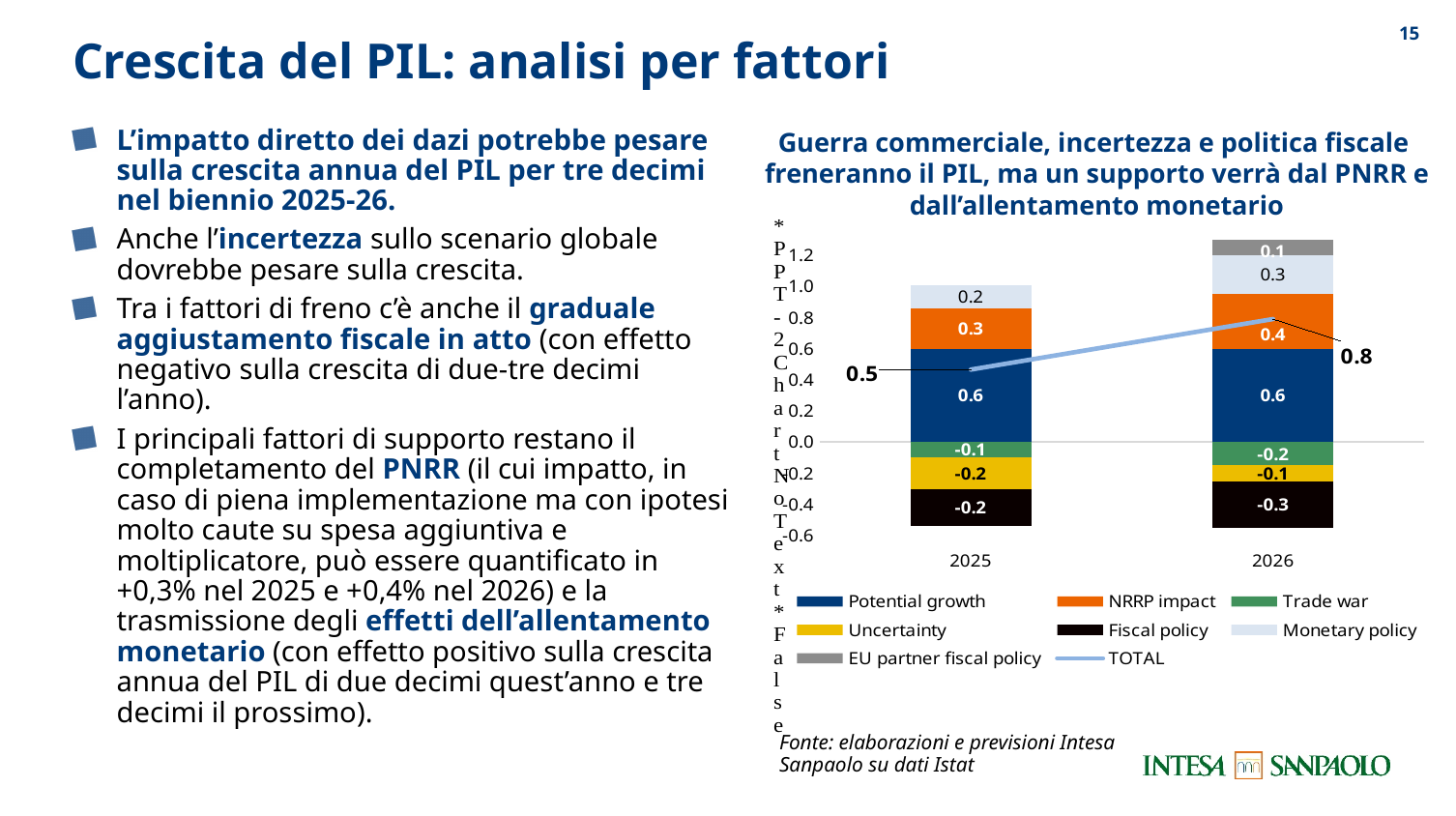
Does the TOTAL line rise or fall from 2025 to 2026? rise What is the value of Fiscal policy for 2026? -0.3 What is the TOTAL value shown for 2026? 0.8 How many entries does the chart legend list? 8 By how much does the TOTAL for 2026 exceed the TOTAL for 2025? 0.3 What is the TOTAL value shown for 2025? 0.5 What is the value of Monetary policy for 2026? 0.3 Is the NRRP impact larger in 2025 or in 2026? 2026 What is the value of NRRP impact for 2025? 0.3 Which series has the largest positive contribution in 2025? Potential growth What is the value of Trade war for 2026? -0.2 How many years are shown on the x axis of the chart? 2